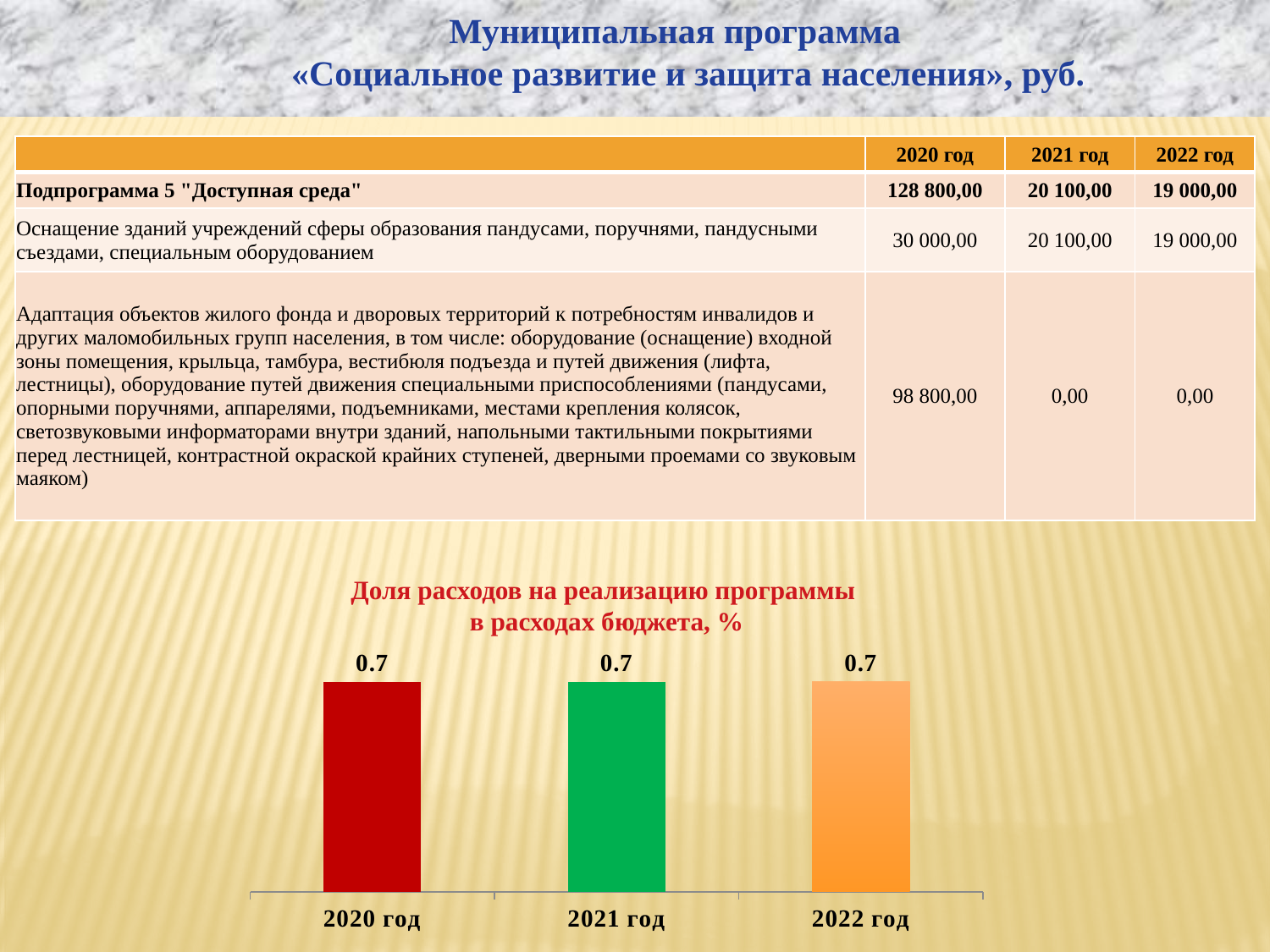
What is the value for 2022 год in the chart? 0.7 What is the title of the chart? Доля расходов на реализацию программы в расходах бюджета, % Do the values rise, fall or stay the same from 2020 год to 2022 год? stay the same What kind of chart is shown on the slide? bar chart What is the difference between the values for 2020 год and 2022 год? 0 How many bars are plotted in the chart? 3 Is the value for 2021 год the same as the value for 2020 год? yes What is the value for 2020 год in the chart? 0.7 What is the value for 2021 год in the chart? 0.7 What colour is the bar for 2021 год? green